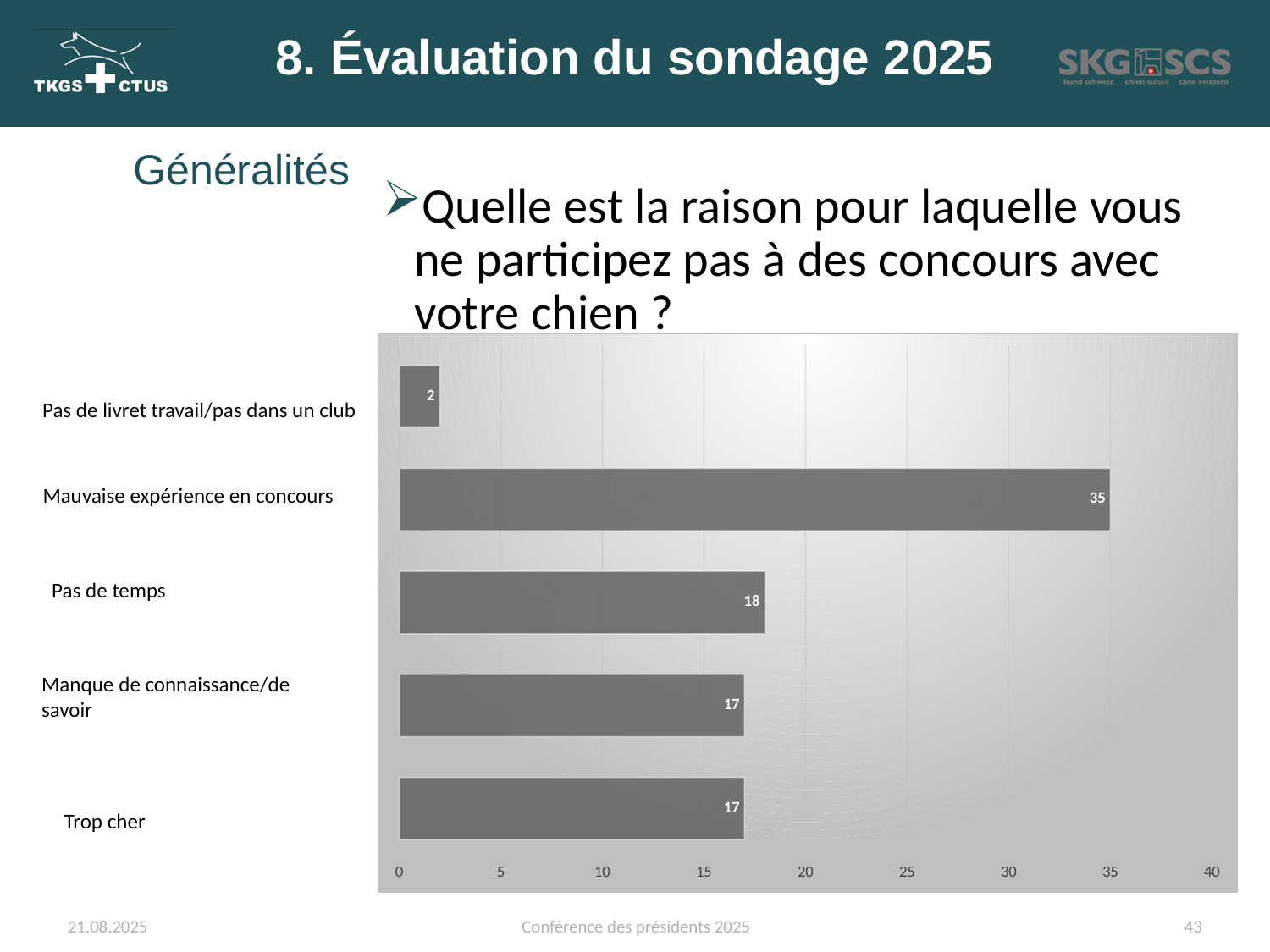
Which reason has the lowest value? Pas de livret travail/pas dans un club What value is shown for "Trop cher"? 17 How many reasons (categories) are shown in the chart? 5 What value is shown for "Pas de temps"? 18 What kind of chart is shown on the slide? bar chart Which is larger, the value for "Pas de temps" or the value for "Trop cher"? Pas de temps What value is shown for "Pas de livret travail/pas dans un club"? 2 Which reason has the highest value? Mauvaise expérience en concours What value is shown for "Mauvaise expérience en concours"? 35 What is the highest value shown on the horizontal axis of the chart? 40 Is the value for "Mauvaise expérience en concours" greater or less than 30? greater What is the difference between the values for "Mauvaise expérience en concours" and "Pas de temps"? 17